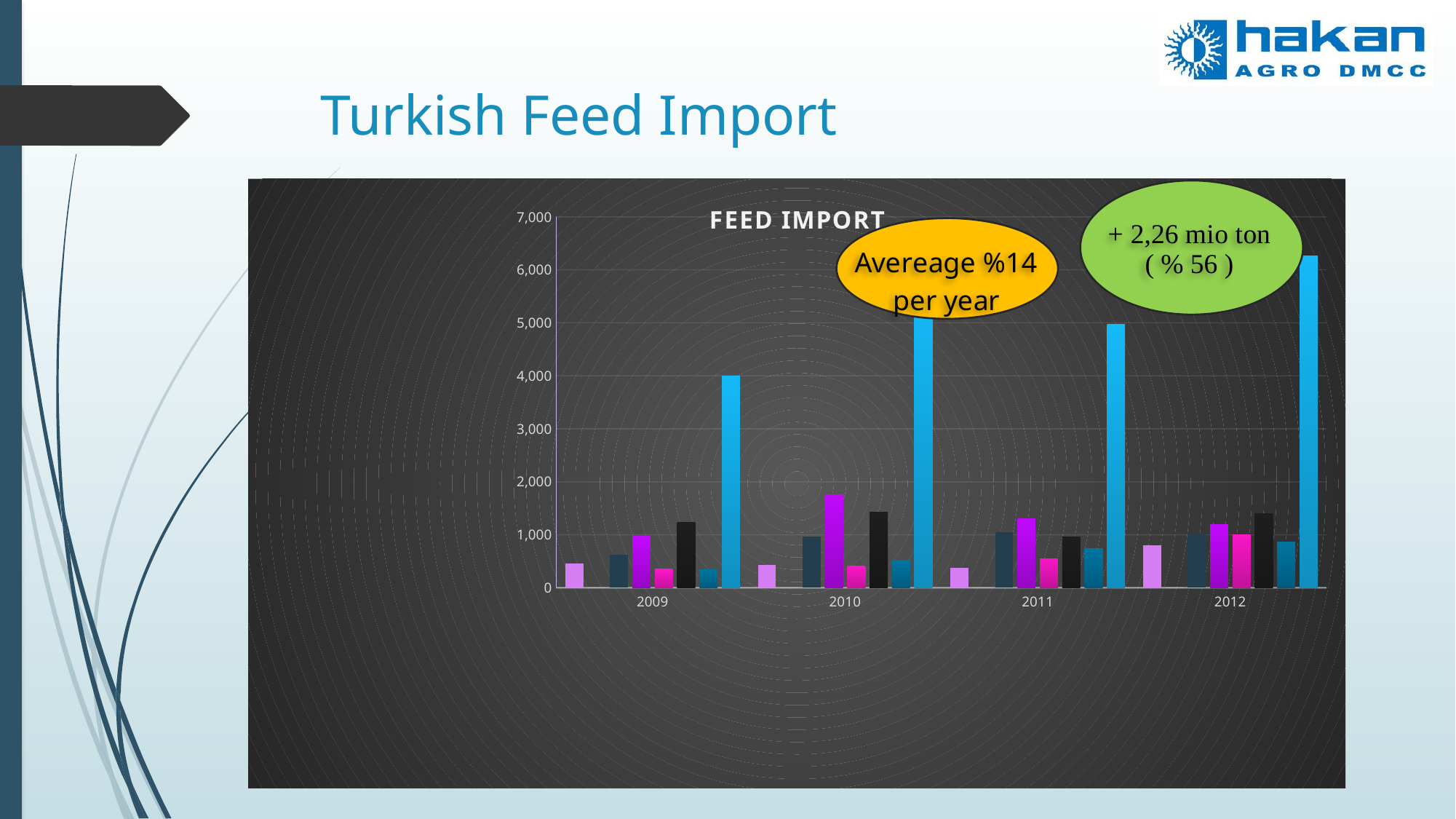
Which year has the lowest light blue bar? 2009 What is the title of the chart? FEED IMPORT Which is larger, the light blue bar for 2009 or the light blue bar for 2012? 2012 Is the tallest (light blue) bar for 2011 greater or less than 6,000? less What average yearly growth does the yellow callout on the chart state? %14 per year Is the tallest (light blue) bar for 2009 greater or less than 3,000? greater How many years are shown on the x axis of the chart? 4 How many bars are plotted for the year 2009? 7 Is the tallest (light blue) bar for 2012 greater or less than 6,000? greater What type of chart is shown on the slide? bar chart Which year has the highest light blue bar? 2012